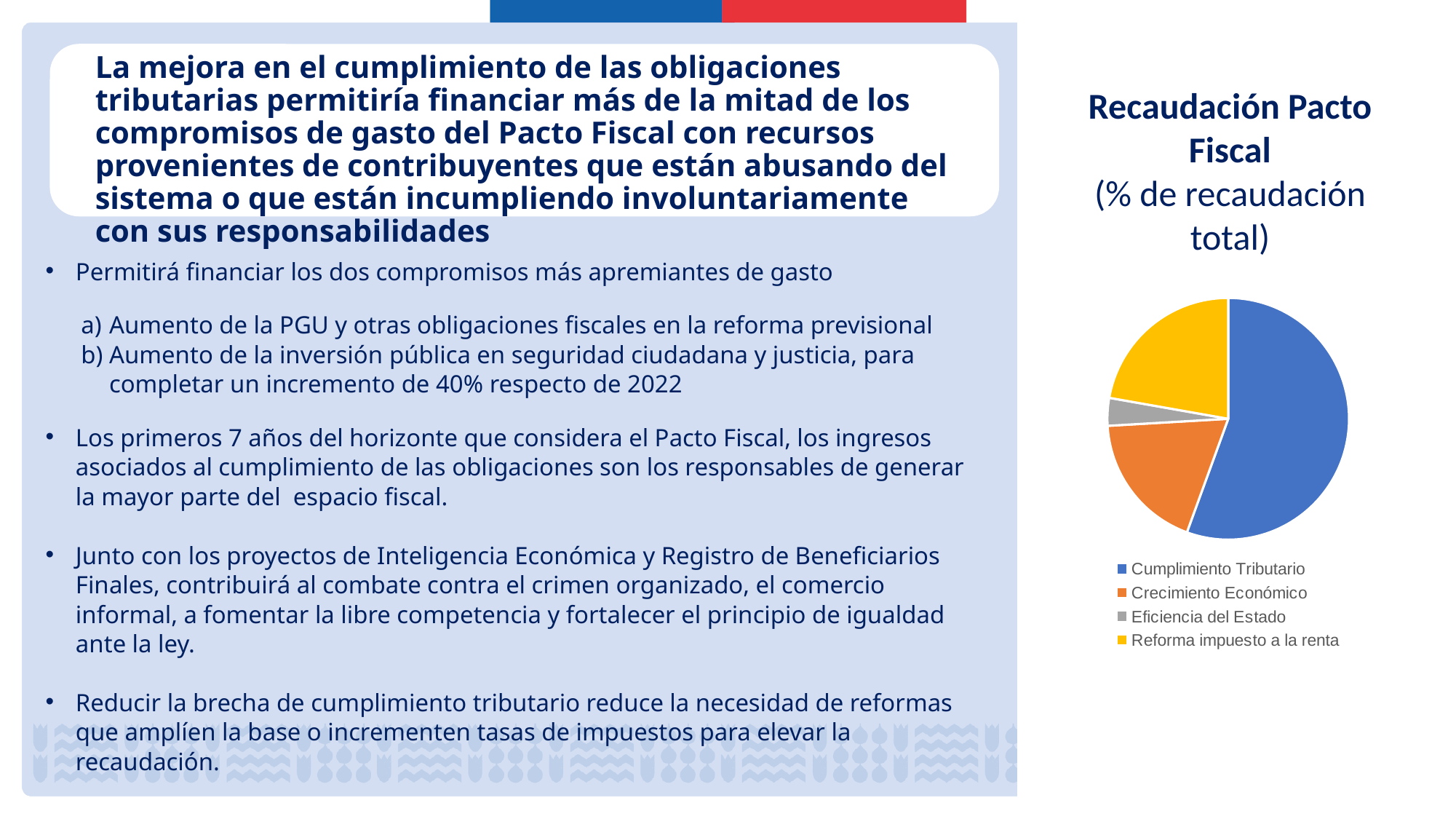
Which category has the largest slice in the pie chart? Cumplimiento Tributario Which slice is larger, Crecimiento Económico or Eficiencia del Estado? Crecimiento Económico What kind of chart is shown on the slide? pie chart What colour is the Reforma impuesto a la renta slice in the pie chart? yellow Which slice is larger, Reforma impuesto a la renta or Eficiencia del Estado? Reforma impuesto a la renta What is the title of the pie chart? Recaudación Pacto Fiscal (% de recaudación total) Which slice is larger, Cumplimiento Tributario or Crecimiento Económico? Cumplimiento Tributario How many entries does the legend of the pie chart list? 4 How many slices does the pie chart have? 4 Which category has the smallest slice in the pie chart? Eficiencia del Estado